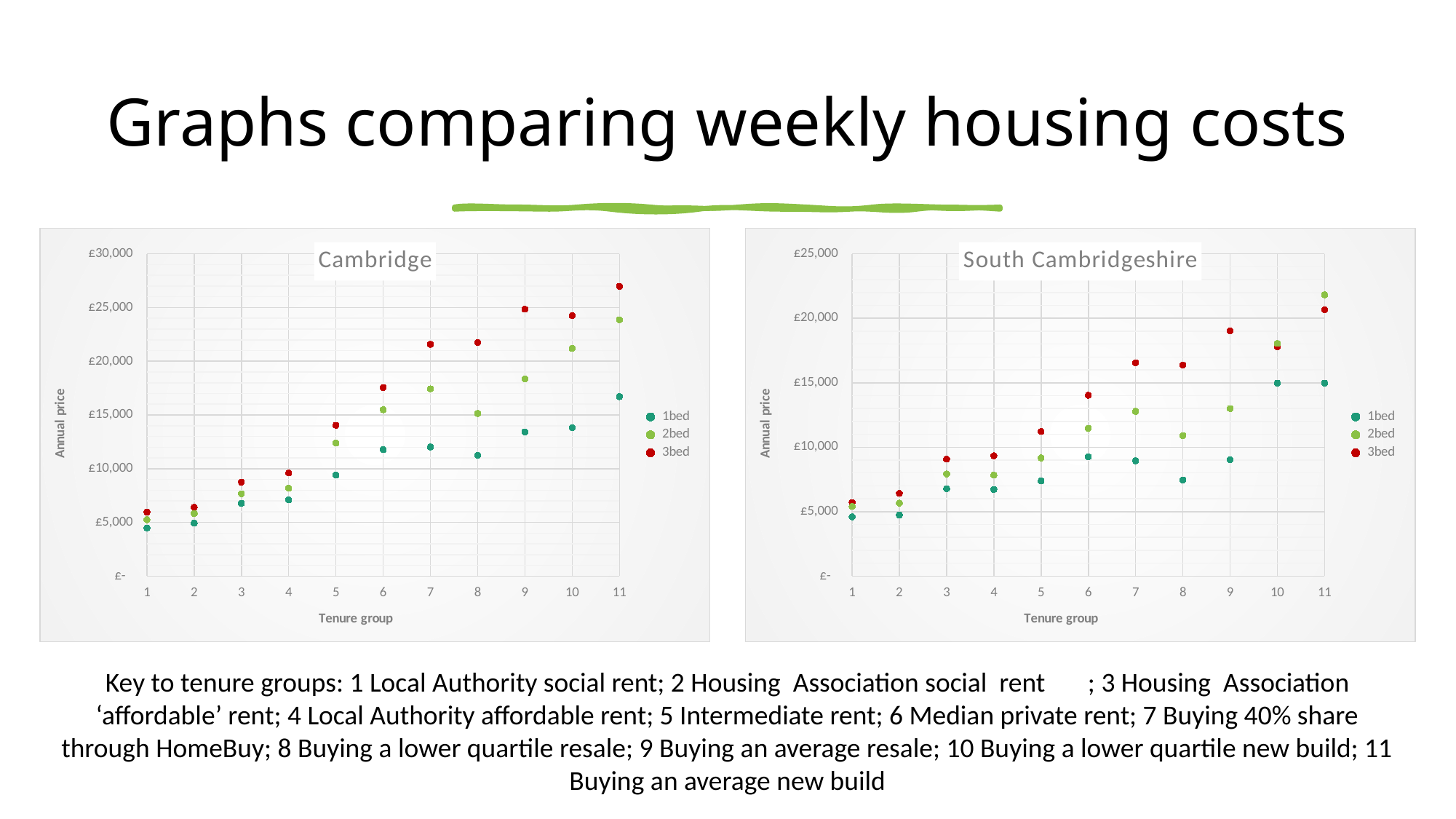
How many series does the legend of the South Cambridgeshire chart list? 3 In the Cambridge chart, which is larger at tenure group 7: the 3bed value or the 1bed value? 3bed In the South Cambridgeshire chart, do the 3bed values generally rise or fall from tenure group 1 to tenure group 11? rise In the South Cambridgeshire chart, is the 2bed value for tenure group 11 greater or less than £20,000? greater What is the label on the y axis of the Cambridge chart? Annual price In the Cambridge chart, which series has the highest point at tenure group 11? 3bed In the Cambridge chart, is the 3bed value for tenure group 6 greater or less than £15,000? greater In the Cambridge chart, is the 3bed value for tenure group 11 greater or less than £25,000? greater What kind of chart is the Cambridge chart? scatter chart How many tenure groups are shown on the x axis of the Cambridge chart? 11